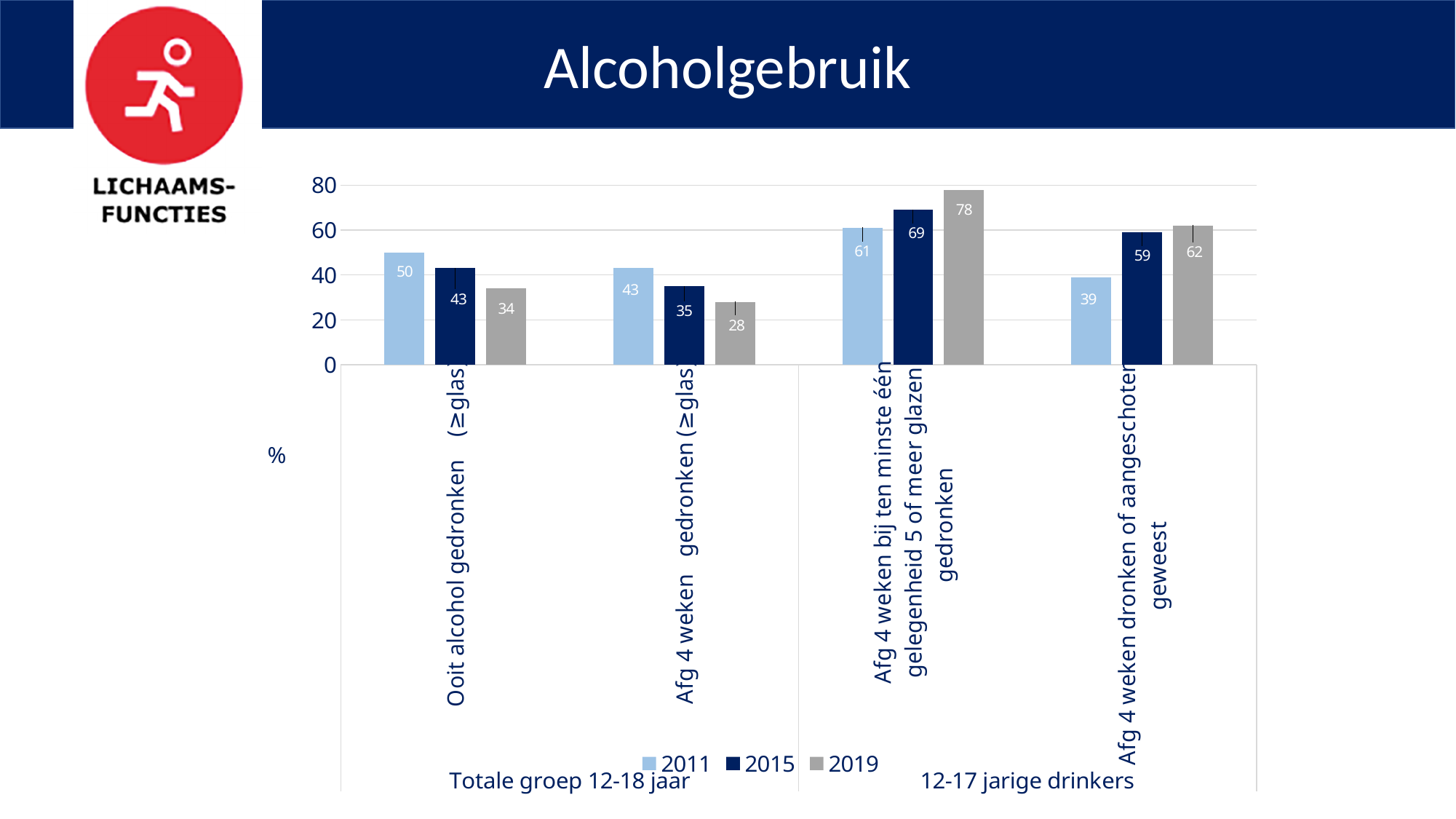
What is the 2015 value for 'Afg 4 weken dronken of aangeschoten geweest'? 59 Which category has the lowest 2015 value? Afg 4 weken gedronken (≥glas) What kind of chart is shown on the slide? bar chart For 'Afg 4 weken dronken of aangeschoten geweest', which is larger: the 2011 value or the 2015 value? 2015 How many series does the legend list? 3 What is the title of the chart? Alcoholgebruik What is the difference between the 2019 and 2011 values for 'Afg 4 weken bij ten minste één gelegenheid 5 of meer glazen gedronken'? 17 What is the 2011 value for 'Ooit alcohol gedronken (≥glas)'? 50 What is the 2019 value for 'Afg 4 weken gedronken (≥glas)'? 28 Which category has the highest 2019 value? Afg 4 weken bij ten minste één gelegenheid 5 of meer glazen gedronken How many categories are shown on the x axis? 4 How do the values for 'Ooit alcohol gedronken (≥glas)' change from 2011 to 2019? they fall